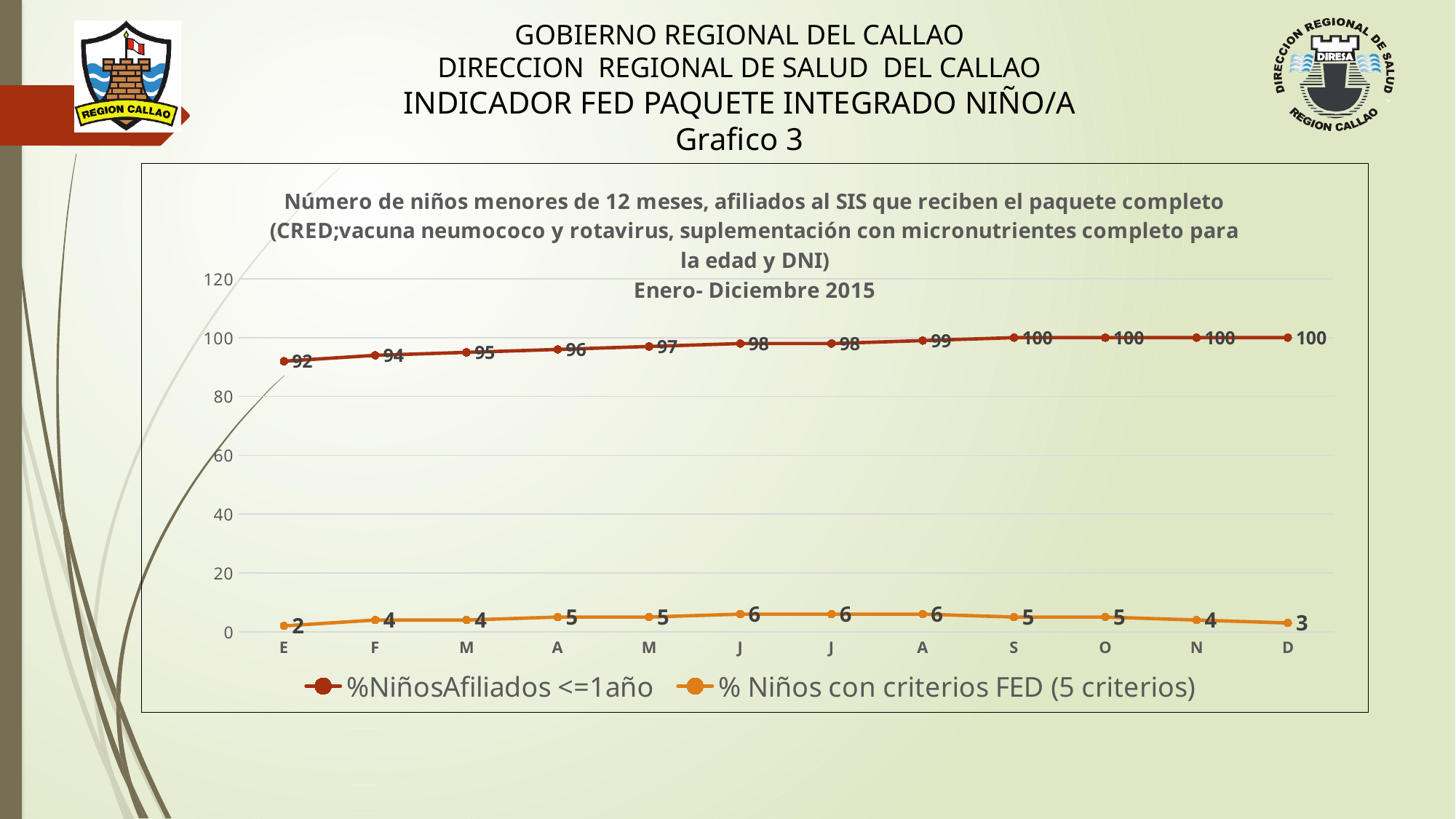
What is the value of % Niños con criterios FED (5 criterios) for D (December)? 3 Does the %NiñosAfiliados <=1año series rise or fall from E to D? Rise What type of chart is shown on the slide? Line chart Which series has the larger value in S: %NiñosAfiliados <=1año or % Niños con criterios FED (5 criterios)? %NiñosAfiliados <=1año How many months are plotted along the x axis? 12 What is the value of % Niños con criterios FED (5 criterios) for the first J (June)? 6 How many series does the legend list? 2 Which month has the lowest value for % Niños con criterios FED (5 criterios)? E What is the value of %NiñosAfiliados <=1año for E (January)? 92 What period does the chart title say the data covers? Enero- Diciembre 2015 What is the difference between the %NiñosAfiliados <=1año values for D and E? 8 Which month has the lowest value for %NiñosAfiliados <=1año? E